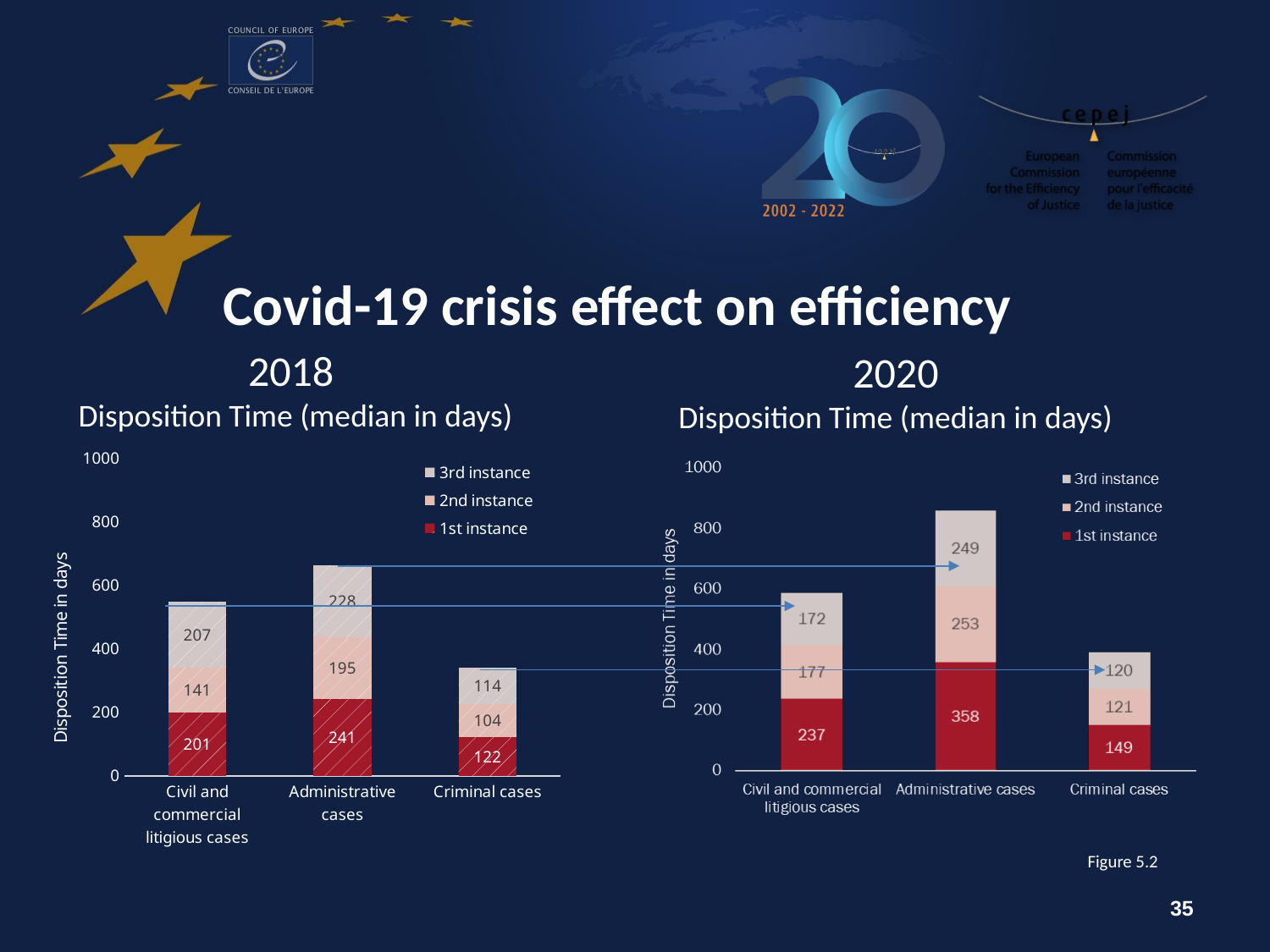
In the 2018 chart, which is larger: the 2nd instance value for Civil and commercial litigious cases or the 2nd instance value for Criminal cases? Civil and commercial litigious cases In the 2018 chart, what is the 1st instance disposition time for Administrative cases? 241 What type of chart is the 2018 Disposition Time chart? Stacked bar chart In the 2020 chart, what is the 3rd instance disposition time for Criminal cases? 120 What is the total of the stacked bar for Criminal cases in the 2018 chart? 340 In the 2020 chart, which category has the lowest 3rd instance value? Criminal cases What is the difference between the 1st instance value for Administrative cases in the 2020 chart and in the 2018 chart? 117 How many series does the legend of the 2020 chart list? 3 In the 2020 chart, is the total stacked bar for Administrative cases greater or less than 800? greater In the 2020 chart, what is the 2nd instance disposition time for Administrative cases? 253 In the 2018 chart, which category has the highest 1st instance value? Administrative cases What is the total of the stacked bar for Civil and commercial litigious cases in the 2020 chart? 586